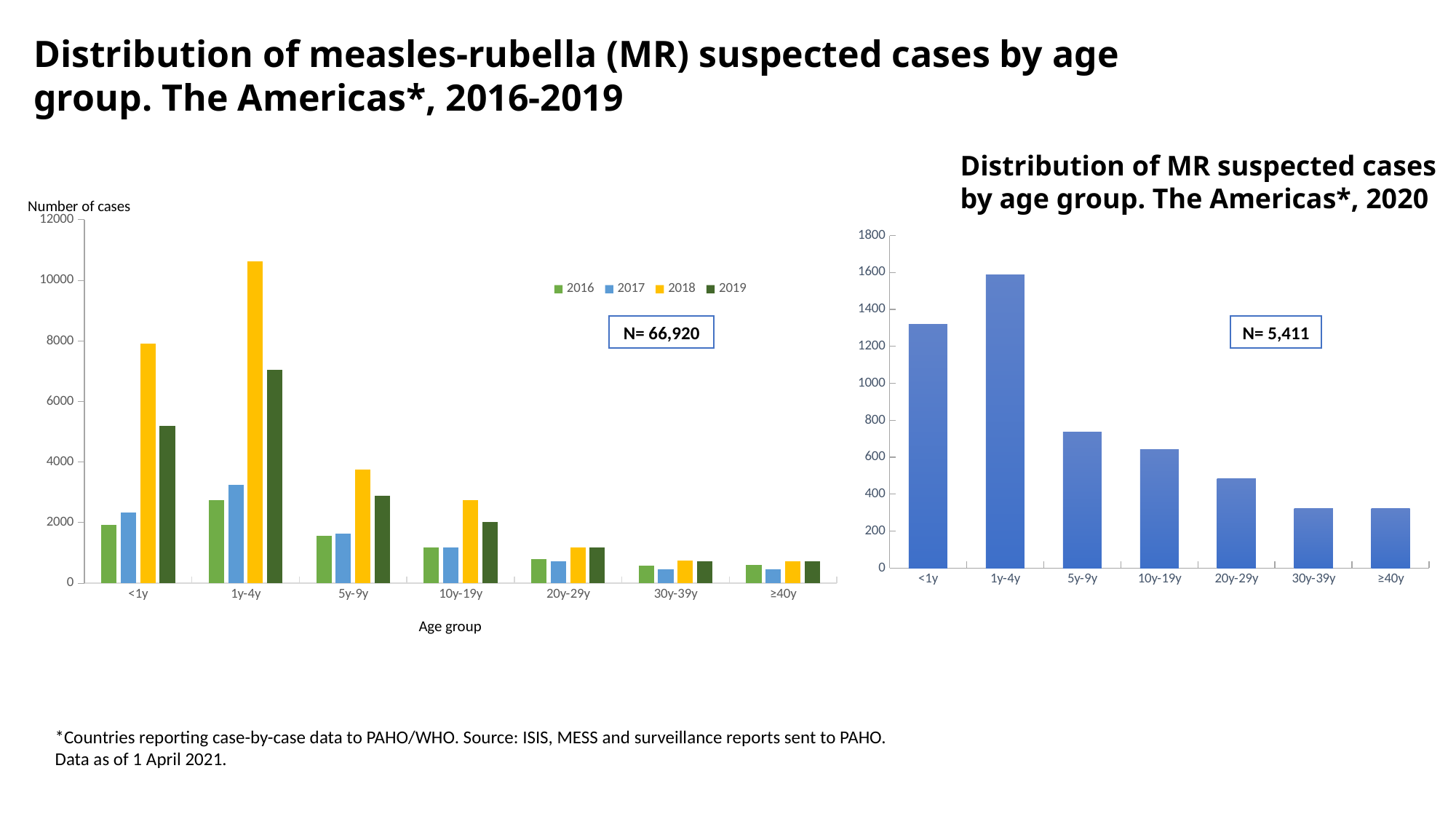
How many series does the legend of the left chart (2016-2019) list? 4 In the right chart (2020), is the value for 1y-4y greater or less than 1400? greater In the right chart (2020), which age group has the highest number of cases? 1y-4y In the right chart (2020), is the value for 20y-29y greater or less than 600? less In the left chart (2016-2019), is the 2018 value for <1y greater or less than 6000? greater In the right chart (2020), which age group has more cases, <1y or 5y-9y? <1y In the left chart (2016-2019), for the 5y-9y age group, which year has the taller bar, 2018 or 2019? 2018 How many age groups are shown on the x axis of the right chart (2020)? 7 What kind of chart is the left chart, 'Distribution of measles-rubella (MR) suspected cases by age group. The Americas*, 2016-2019'? bar chart What is the N value shown on the right chart (2020)? N= 5,411 In the left chart (2016-2019), which age group has the tallest bar for 2018? 1y-4y